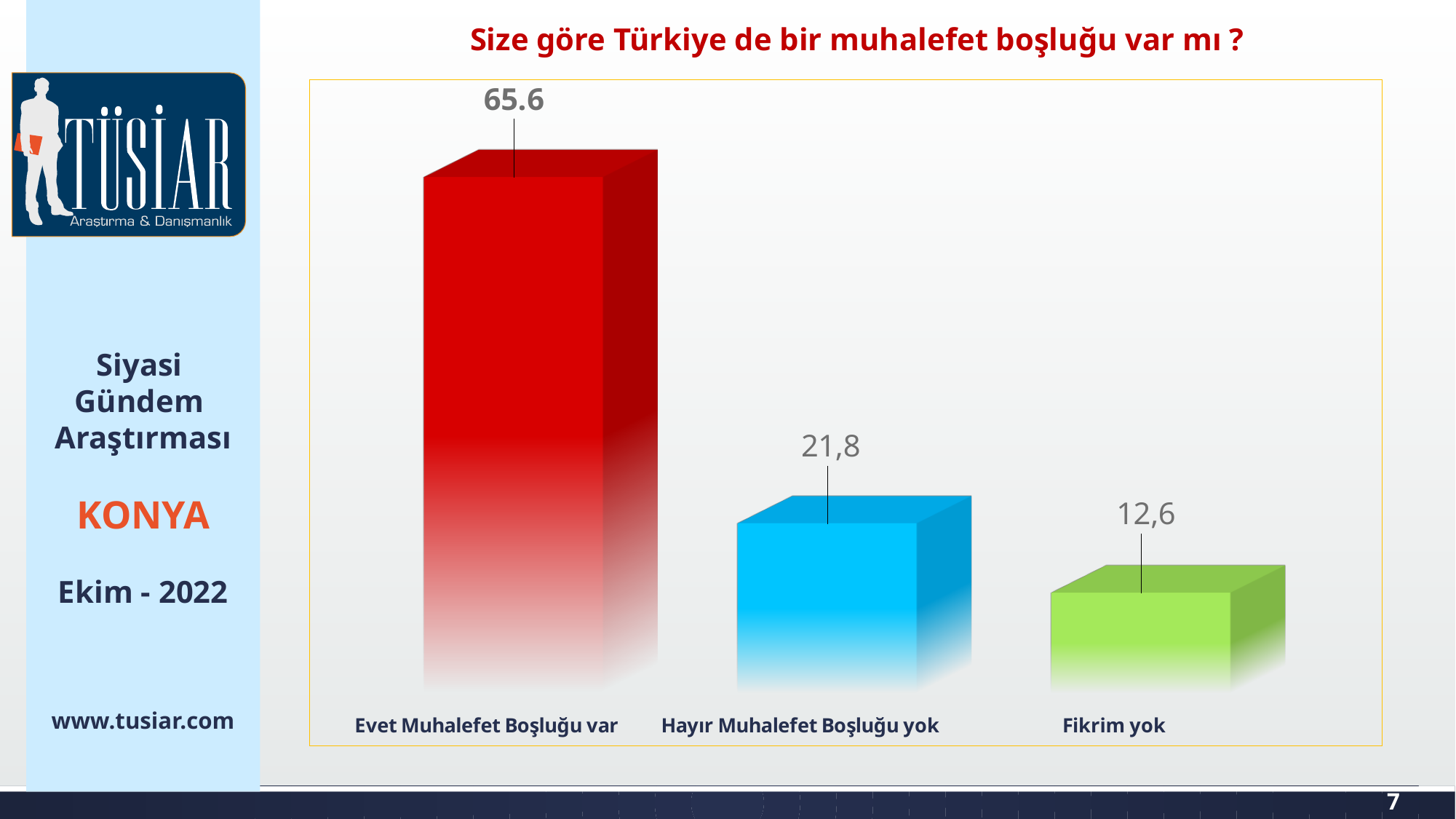
What is the title of the chart? Size göre Türkiye de bir muhalefet boşluğu var mı ? What is the value for "Hayır Muhalefet Boşluğu yok"? 21,8 Which category has the lowest value? Fikrim yok How many categories are shown in the chart? 3 Which is larger, the value for "Evet Muhalefet Boşluğu var" or the value for "Hayır Muhalefet Boşluğu yok"? Evet Muhalefet Boşluğu var Which category has the highest value? Evet Muhalefet Boşluğu var What is the value for "Fikrim yok"? 12,6 What is the value for "Evet Muhalefet Boşluğu var"? 65.6 What kind of chart is shown on the slide? Bar chart Which is larger, the value for "Hayır Muhalefet Boşluğu yok" or the value for "Fikrim yok"? Hayır Muhalefet Boşluğu yok What is the difference between the values for "Hayır Muhalefet Boşluğu yok" and "Fikrim yok"? 9,2 Do the values rise or fall from left to right across the categories? Fall